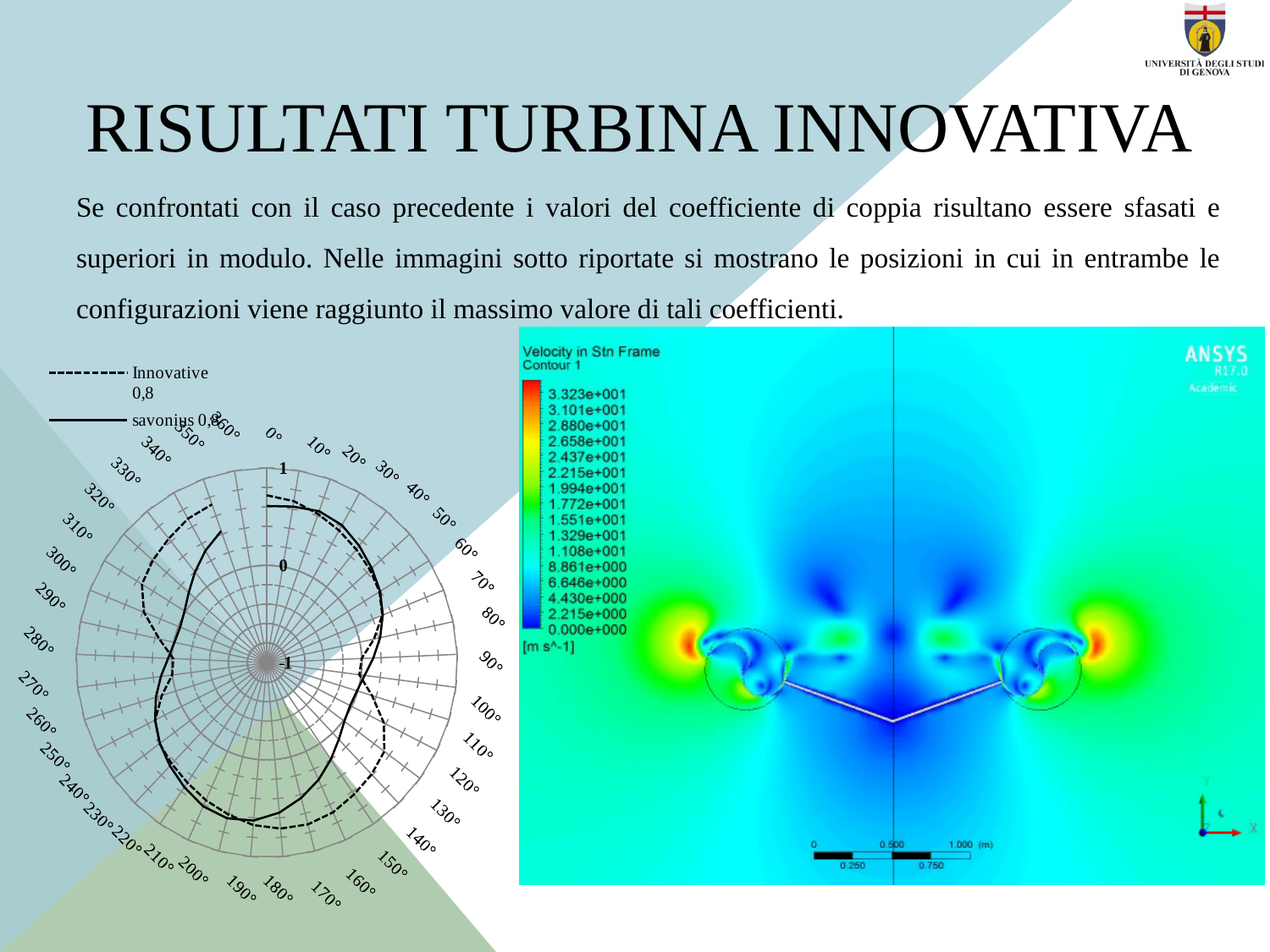
What is the maximum value shown on the radial axis of the radar chart? 1 In the radar chart, is the value for Innovative 0,8 at 130° greater or less than 0? greater What is the angular step between consecutive angle labels on the radar chart? 10° What kind of chart is shown on the left of the slide? radar chart In the radar chart, is the value for savonius 0,8 at 60° greater or less than 0? greater In the radar chart, is the value for Innovative 0,8 at 0° greater or less than 0? greater How many series does the legend of the radar chart list? 2 Which series in the radar chart is drawn with a solid line? savonius 0,8 Which series in the radar chart is drawn with a dashed line? Innovative 0,8 What is the minimum value shown on the radial axis of the radar chart? -1